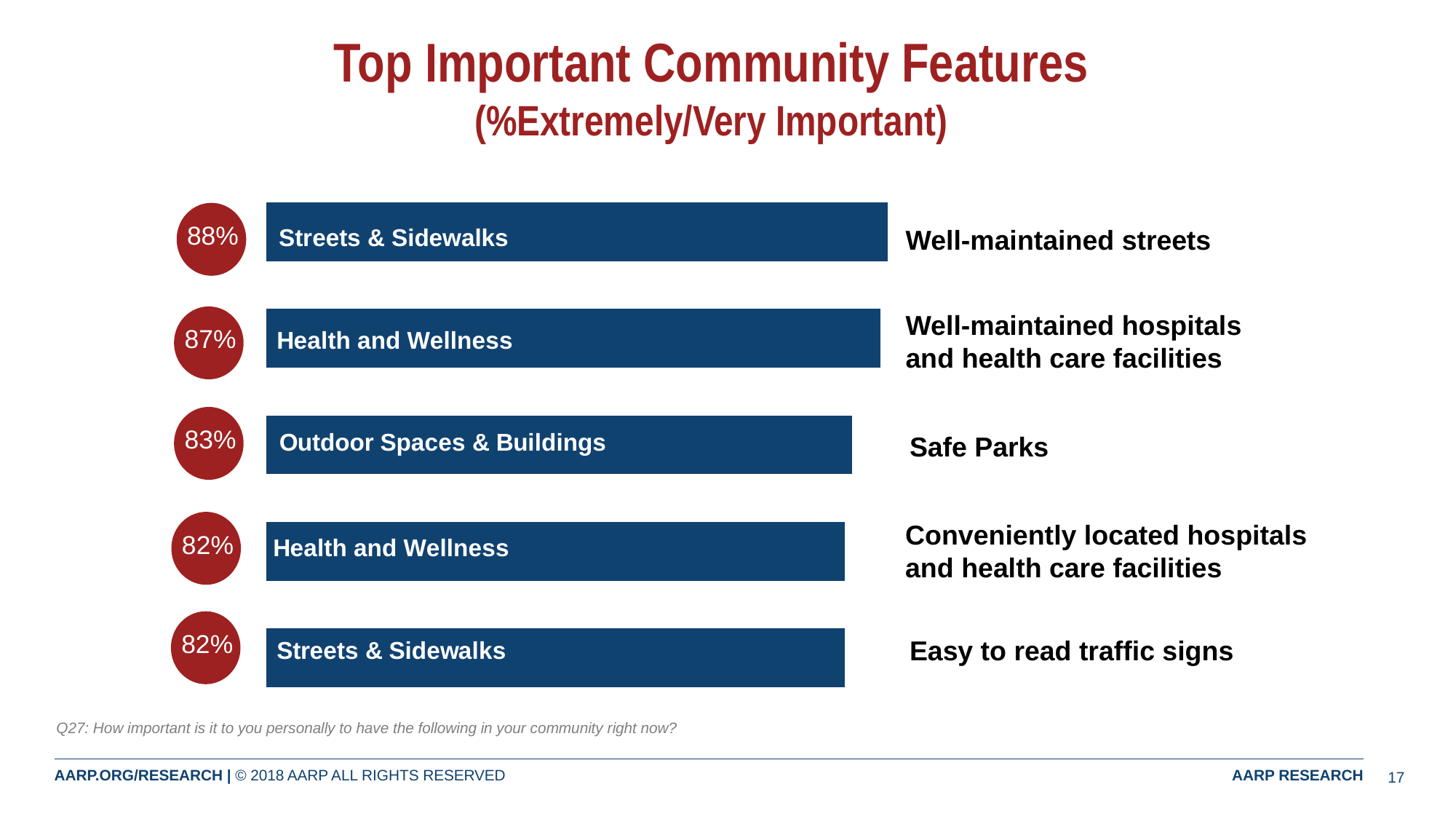
What is the lowest percentage shown on the chart? 82% How many community features are shown on the chart? 5 Which domain label appears inside the bar for Safe Parks? Outdoor Spaces & Buildings What is the difference between well-maintained hospitals and health care facilities and conveniently located hospitals and health care facilities? 5% Which community feature has the highest percentage? Well-maintained streets What is the difference between the values for well-maintained streets and Safe Parks? 5% What is the value shown for Safe Parks? 83% What percentage rated well-maintained streets as extremely/very important? 88% What kind of chart is shown on the slide? Bar chart What percentage is shown for easy to read traffic signs? 82% What is the value for well-maintained hospitals and health care facilities? 87% Which has a higher value: Safe Parks or easy to read traffic signs? Safe Parks